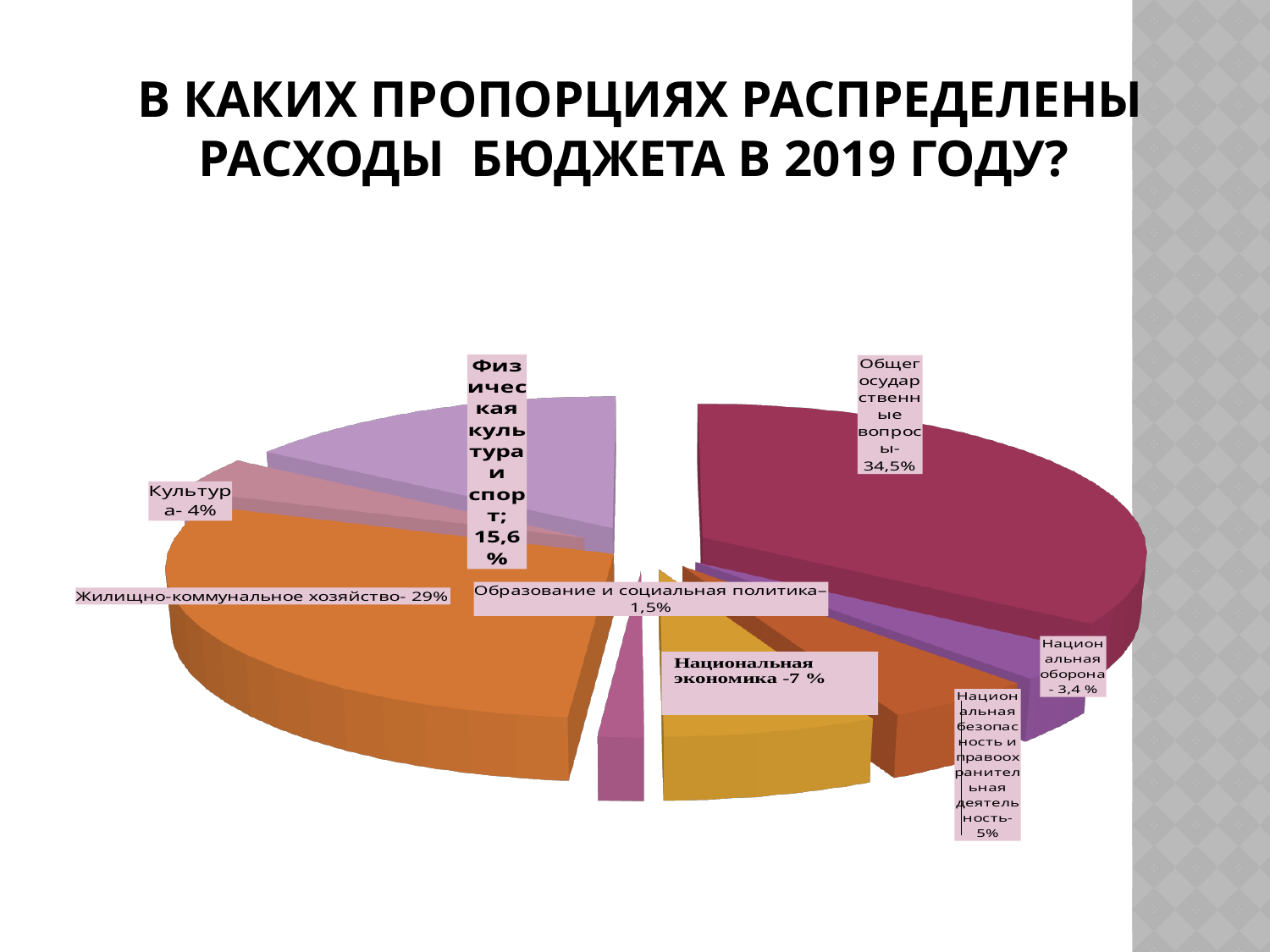
How many slices does the pie chart have? 8 What share is shown for Физическая культура и спорт? 15,6% What share of the budget expenses goes to Общегосударственные вопросы? 34,5% Which is larger: the share for Культура or the share for Национальная оборона? Культура What kind of chart is shown on the slide? Pie chart What is the difference between the shares of Общегосударственные вопросы and Жилищно-коммунальное хозяйство? 5,5% What year do the budget expenses in the slide title refer to? 2019 What share is shown for Образование и социальная политика? 1,5% Which category has the smallest share of the pie? Образование и социальная политика Which category has the largest share of the pie? Общегосударственные вопросы What share is shown for Национальная экономика? 7 % What share is shown for Жилищно-коммунальное хозяйство? 29%